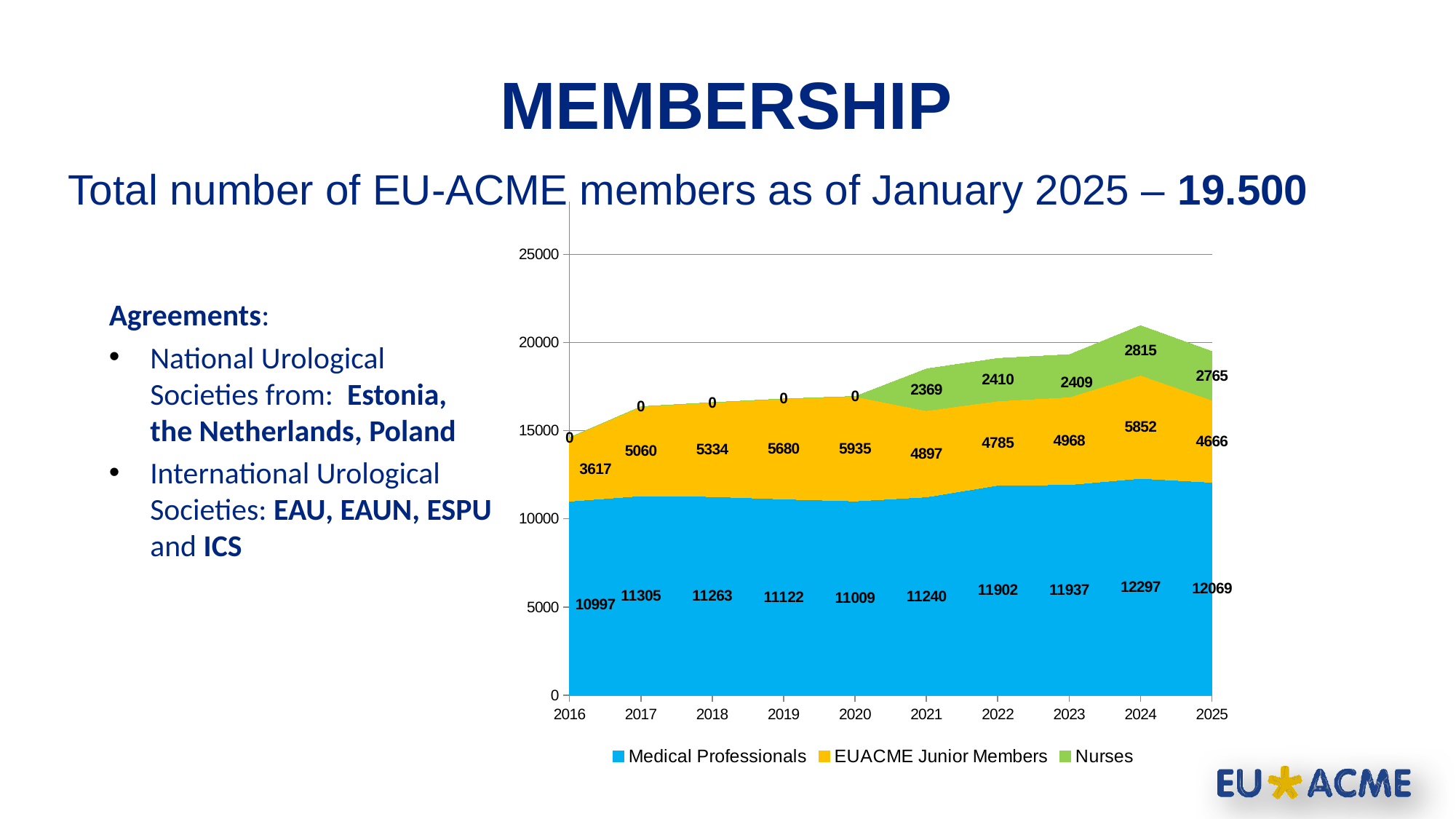
What is the value for Medical Professionals in 2024? 12297 How many series does the chart legend list? 3 What is the value for Nurses in 2021? 2369 What is the value for EUACME Junior Members in 2020? 5935 What kind of chart is shown on the slide? Stacked area chart Which is larger, the EUACME Junior Members value in 2024 or in 2025? 2024 How many years are plotted along the x axis of the chart? 10 In which year is the Medical Professionals value lowest? 2016 In which year is the Nurses value highest? 2024 What is the difference between the Medical Professionals values for 2024 and 2025? 228 In which year is the Medical Professionals value highest? 2024 What is the total of all three series in 2025? 19500